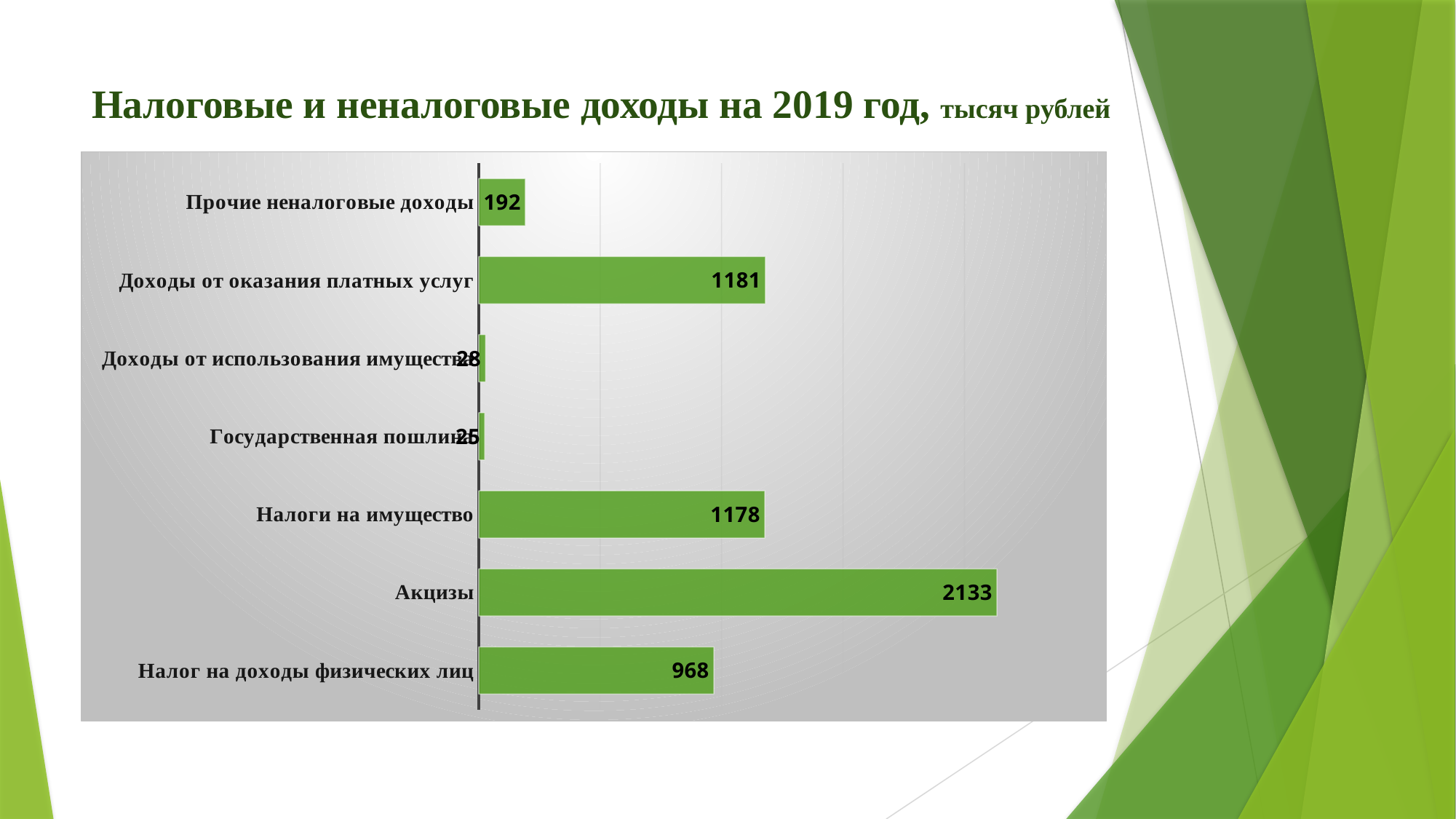
How many categories are shown in the chart? 7 What kind of chart is shown on the slide? Bar chart What is the value for Налог на доходы физических лиц? 968 What is the difference between the values for Акцизы and Налог на доходы физических лиц? 1165 What is the value for Акцизы? 2133 What is the value for Доходы от оказания платных услуг? 1181 Which category has the highest value? Акцизы Which is larger, the value for Прочие неналоговые доходы or the value for Налог на доходы физических лиц? Налог на доходы физических лиц What is the value for Налоги на имущество? 1178 What is the value for Прочие неналоговые доходы? 192 What is the difference between the values for Доходы от оказания платных услуг and Налоги на имущество? 3 Which is larger, the value for Акцизы or the value for Налоги на имущество? Акцизы